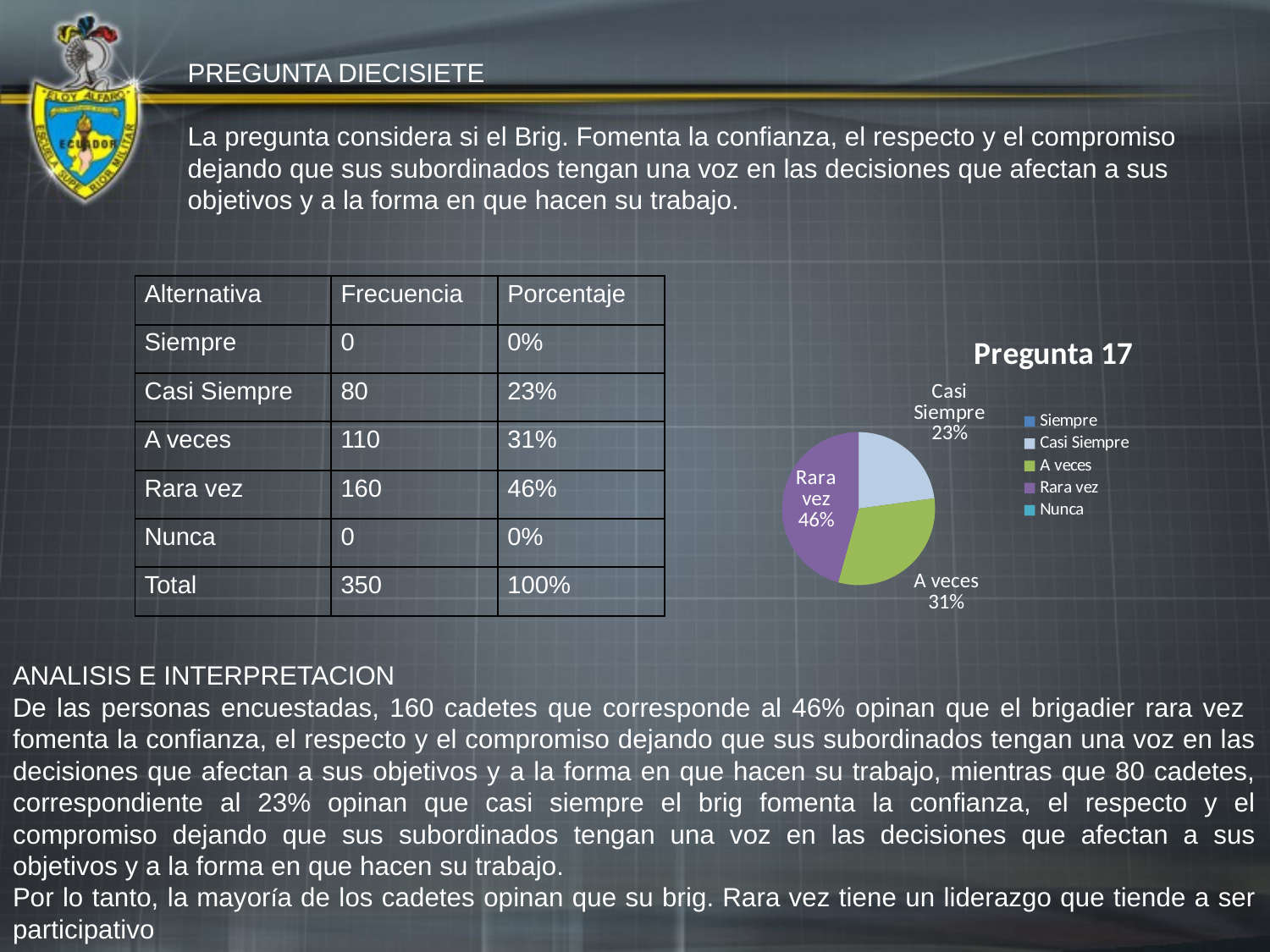
What type of chart is shown on the slide? pie chart Among the slices with labels shown on the pie, which category has the smallest share? Casi Siempre What is the title of the chart? Pregunta 17 Which category has the largest slice in the pie chart? Rara vez What is the difference in percentage points between the 'A veces' and 'Casi Siempre' slices? 8% What share of the pie does the 'A veces' slice represent? 31% How many slices with a visible percentage label are shown on the pie chart? 3 What is the difference in percentage points between the 'Rara vez' and 'A veces' slices? 15% Which slice is larger, 'A veces' or 'Casi Siempre'? A veces What share of the pie does the 'Rara vez' slice represent? 46% How many entries does the chart's legend list? 5 What share of the pie does the 'Casi Siempre' slice represent? 23%